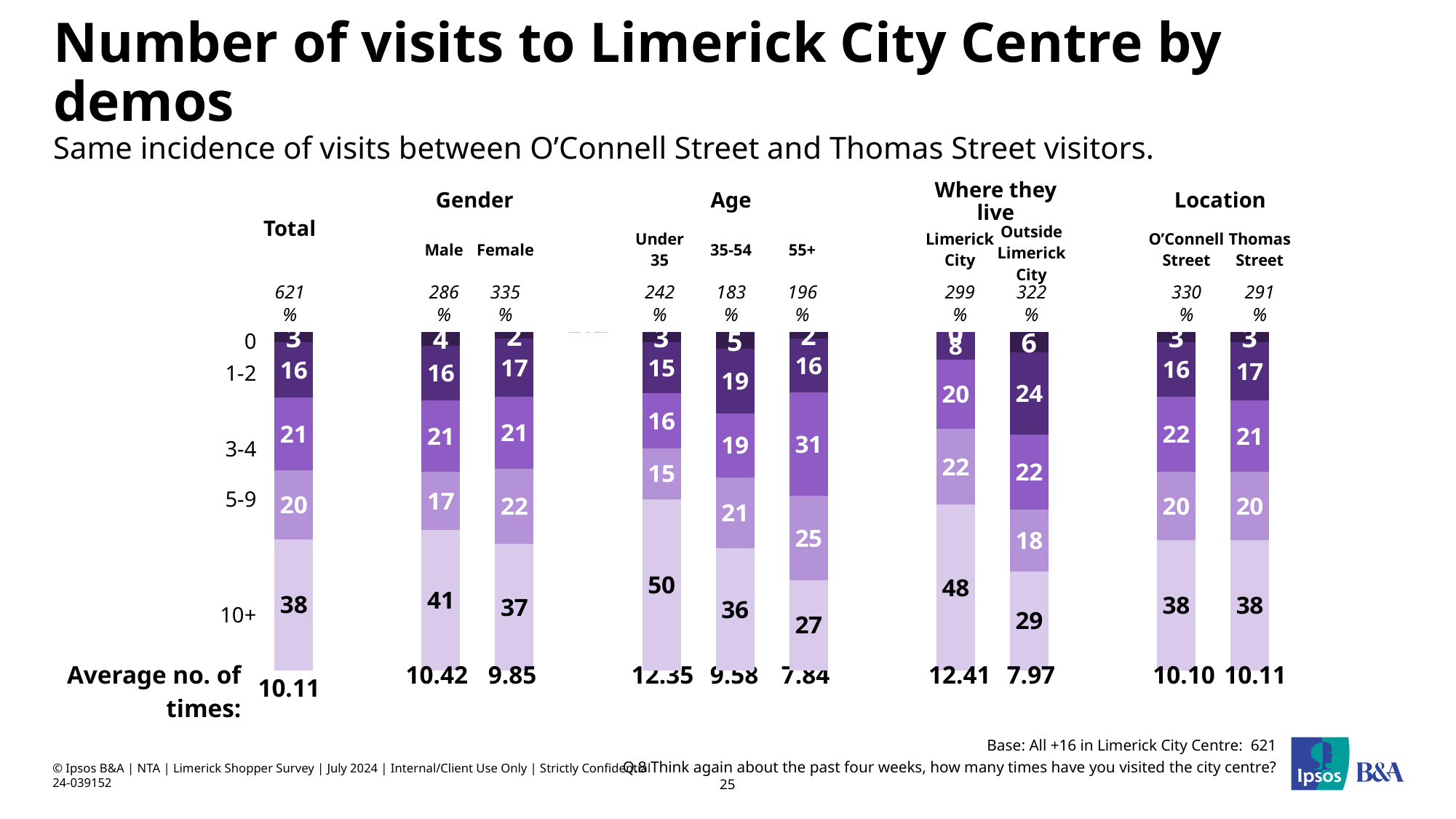
Which has a higher share of 1-2 visits: Limerick City or Outside Limerick City? Outside Limerick City How many demographic groups (bars) are shown in the chart? 10 What is the average number of visits for Limerick City residents? 12.41 What percentage of 55+ respondents visited 3-4 times? 31 What is the average number of visits for O'Connell Street visitors? 10.10 Which group has the lowest average number of visits? 55+ What is the base size for the Female group? 335 How many visit-frequency categories are stacked in each bar? 5 What percentage of Under 35 respondents visited the city centre 10+ times? 50 What is the difference between the Male and Female percentages for 10+ visits? 4 What type of chart is shown on the slide? Stacked bar chart Which age group has the highest share of 10+ visits? Under 35